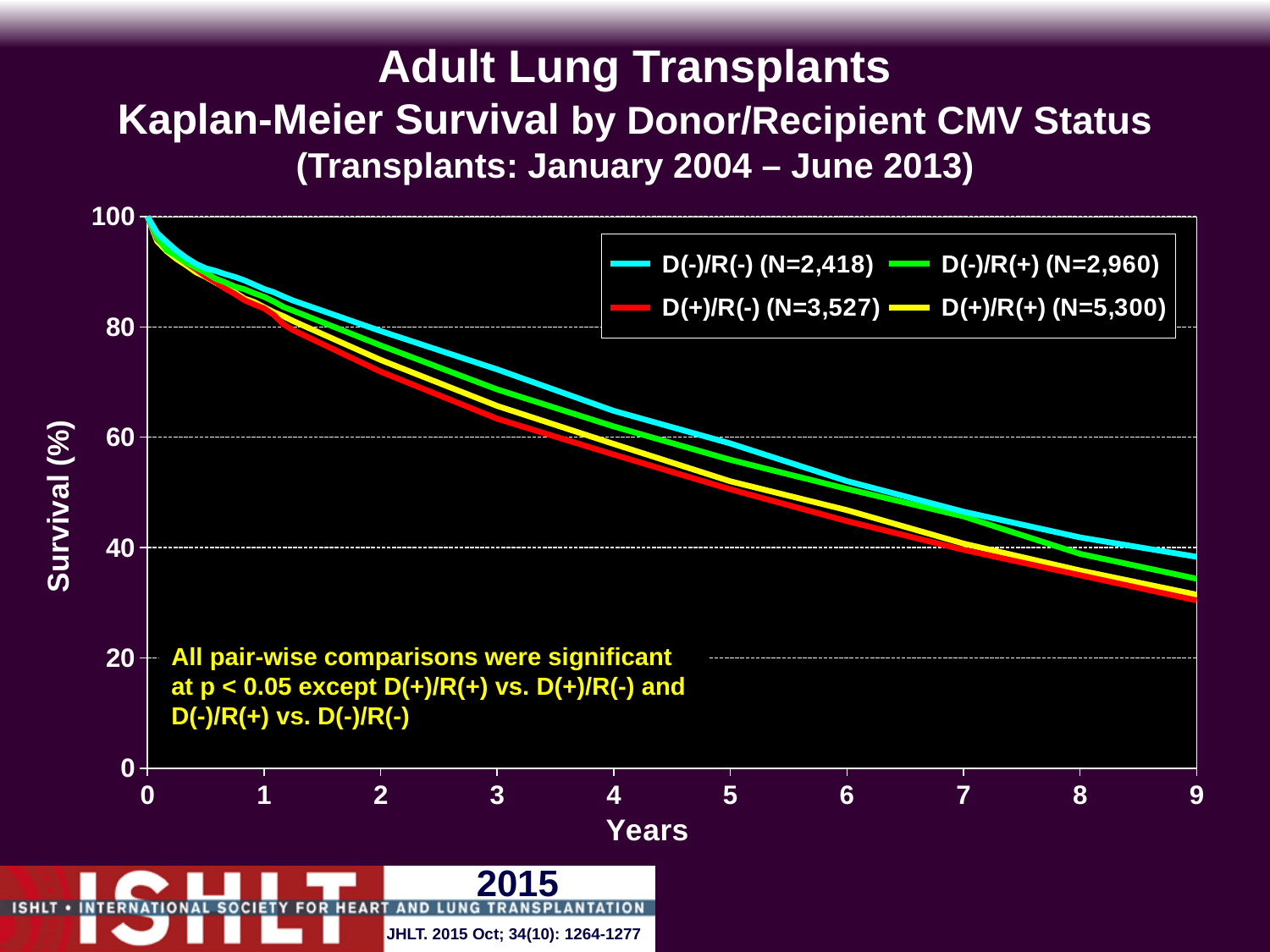
What is the N for the D(-)/R(-) group shown in the legend? N=2,418 How many series does the legend list? 4 Is the survival for D(-)/R(-) at 1 year greater or less than 80? greater Which group has the lowest survival at 9 years? D(+)/R(-) Which group has the largest N in the legend? D(+)/R(+) Is the survival for D(+)/R(-) at 9 years greater or less than 40? less What is the label of the y axis? Survival (%) What is the N for the D(+)/R(+) group shown in the legend? N=5,300 Which group has the highest survival at 9 years? D(-)/R(-) Do the survival curves rise or fall as years increase? Fall Which group has the smallest N in the legend? D(-)/R(-) What kind of chart is shown on the slide? Line chart